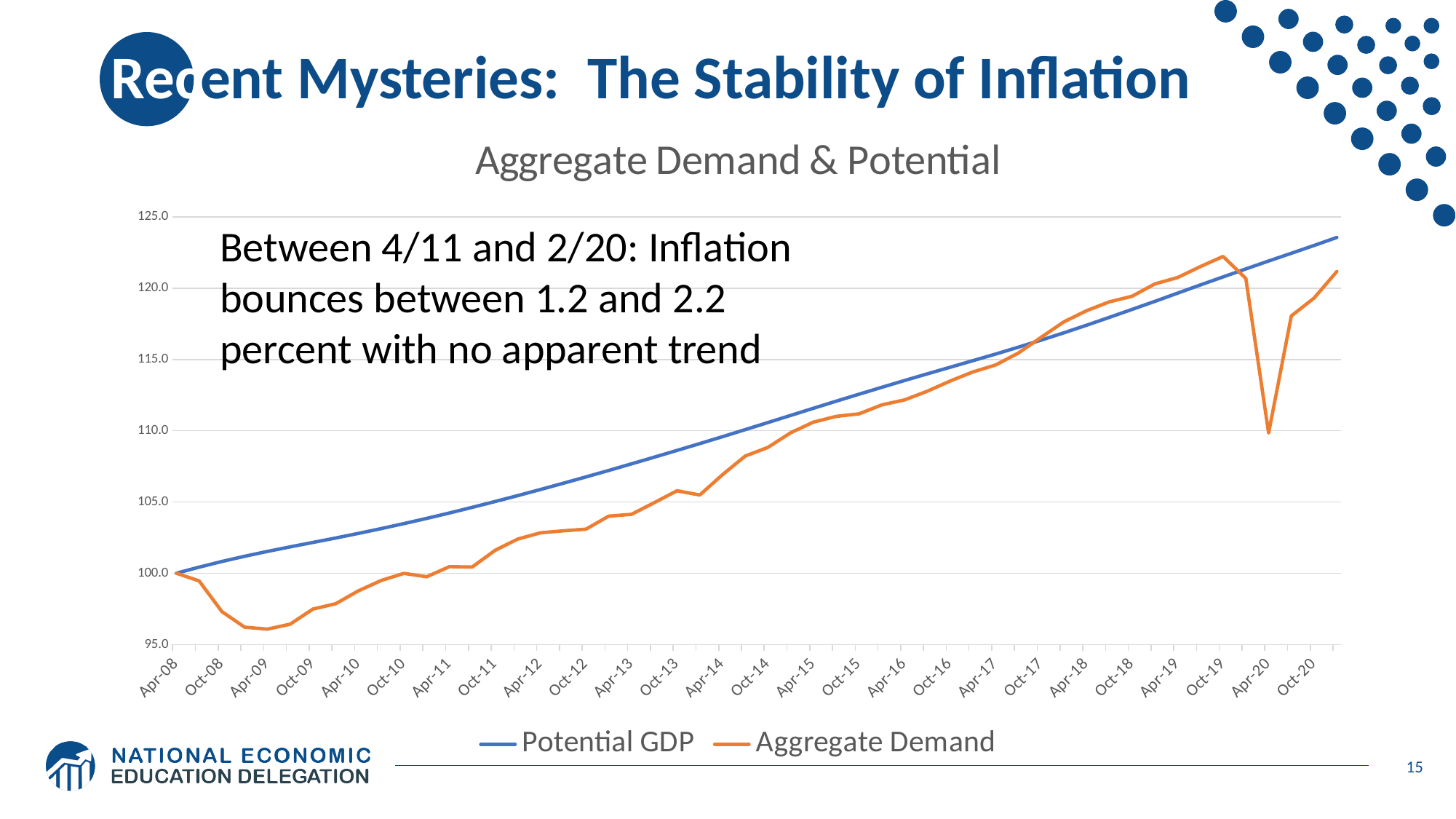
Is the value of Potential GDP at Oct-20 greater or less than 120.0? greater Which colour is used for the Aggregate Demand line? orange Is the value of Aggregate Demand at Apr-20 greater or less than 115.0? less How many series does the legend list? 2 Is the value of Aggregate Demand at Apr-09 greater or less than 100.0? less Around which x-axis label does Aggregate Demand reach its lowest value? Apr-09 At Oct-19, which series has the higher value, Potential GDP or Aggregate Demand? Aggregate Demand What kind of chart is shown on the slide? line chart What is the value of Aggregate Demand at Apr-08? 100.0 What is the value of Potential GDP at Apr-08? 100.0 Does Potential GDP rise or fall along the x axis? rise What is the title of the chart? Aggregate Demand & Potential